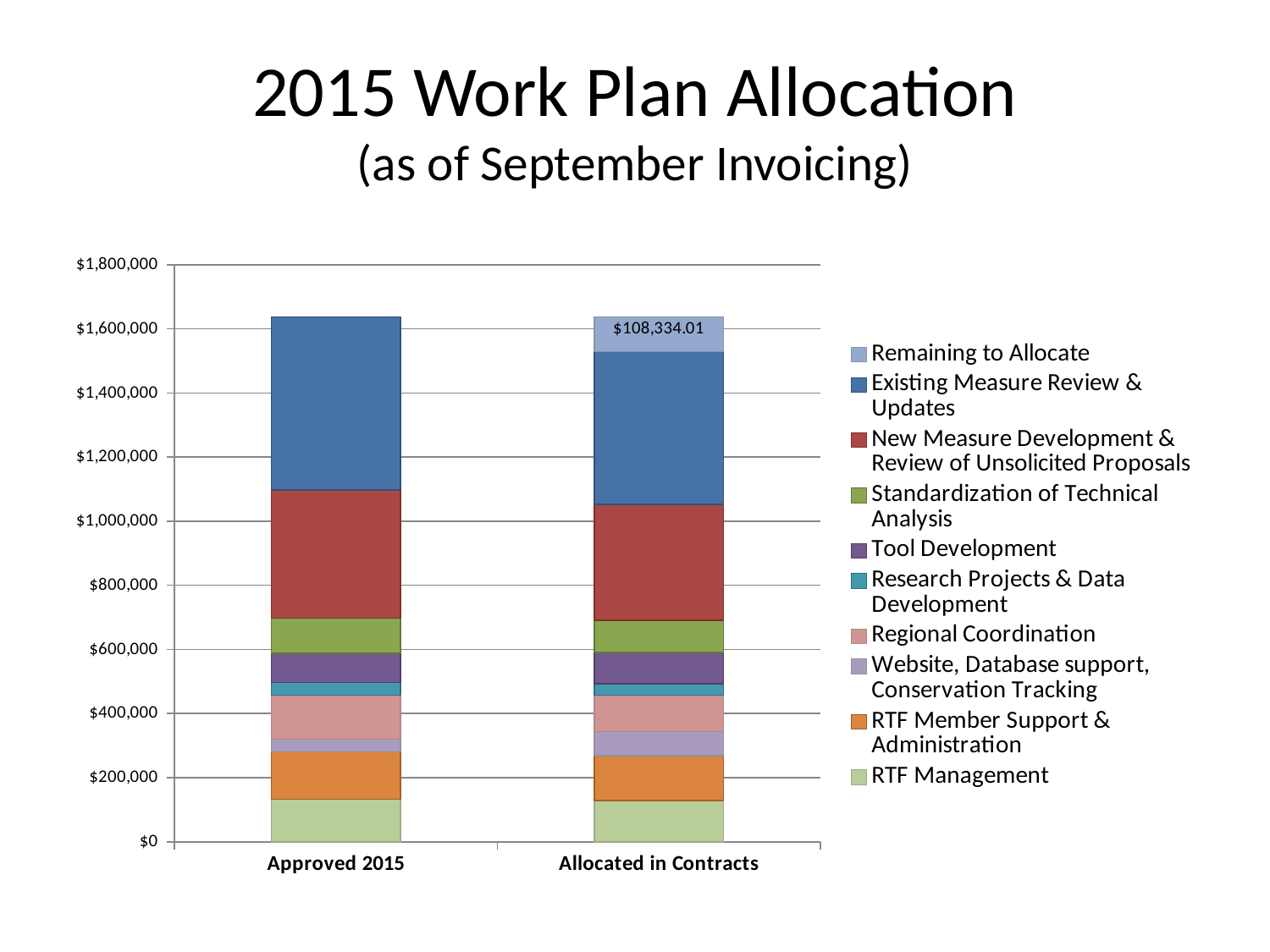
In the Approved 2015 bar, which segment is larger: Existing Measure Review & Updates or RTF Management? Existing Measure Review & Updates Is the New Measure Development & Review of Unsolicited Proposals segment in the Allocated in Contracts bar greater or less than $200,000? greater Which bar includes a Remaining to Allocate segment? Allocated in Contracts Which series has the largest segment in the Approved 2015 bar? Existing Measure Review & Updates Is the total of the Allocated in Contracts bar greater or less than $1,400,000? greater What is the highest value labelled on the chart's y axis? $1,800,000 Is the total of the Approved 2015 bar greater or less than $1,400,000? greater How many series does the chart's legend list? 10 What is the value of the Remaining to Allocate segment in the Allocated in Contracts bar? $108,334.01 How many categories are shown on the x axis of the chart? 2 What kind of chart is shown on the slide? Stacked bar chart